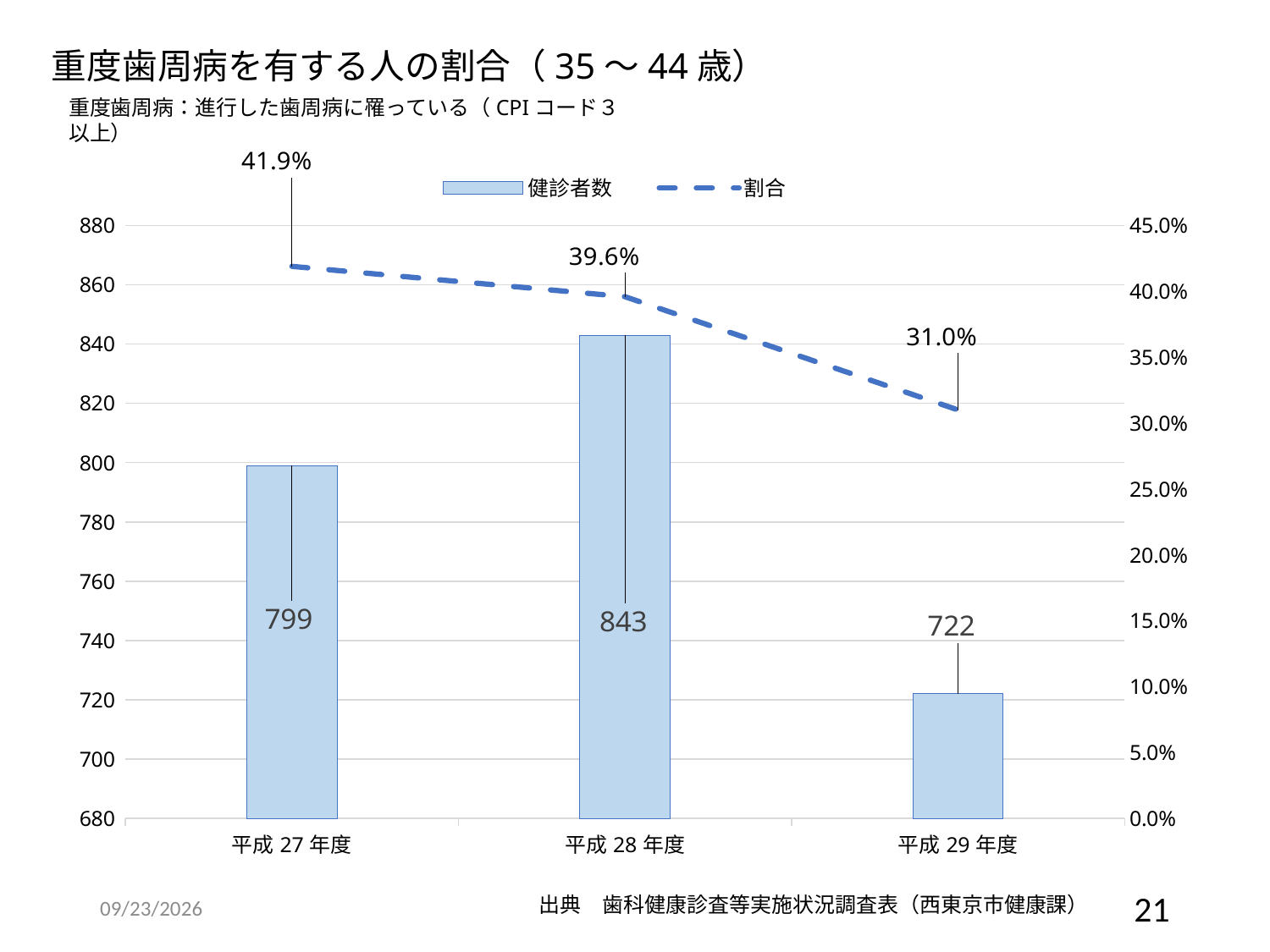
How many series does the legend list? 2 Which year has the highest 健診者数? 平成 28 年度 Which is larger, the 健診者数 for 平成 27 年度 or for 平成 29 年度? 平成 27 年度 Which year has the lowest 割合? 平成 29 年度 What is the difference in 割合 between 平成 27 年度 and 平成 28 年度? 2.3% What is the 割合 value for 平成 29 年度? 31.0% What is the difference in 健診者数 between 平成 28 年度 and 平成 29 年度? 121 What is the 割合 value for 平成 27 年度? 41.9% What is the title of the chart? 重度歯周病を有する人の割合（35～44歳） What is the 健診者数 value for 平成 28 年度? 843 How many years are shown on the x axis? 3 Does the 割合 line rise or fall from 平成 27 年度 to 平成 29 年度? fall